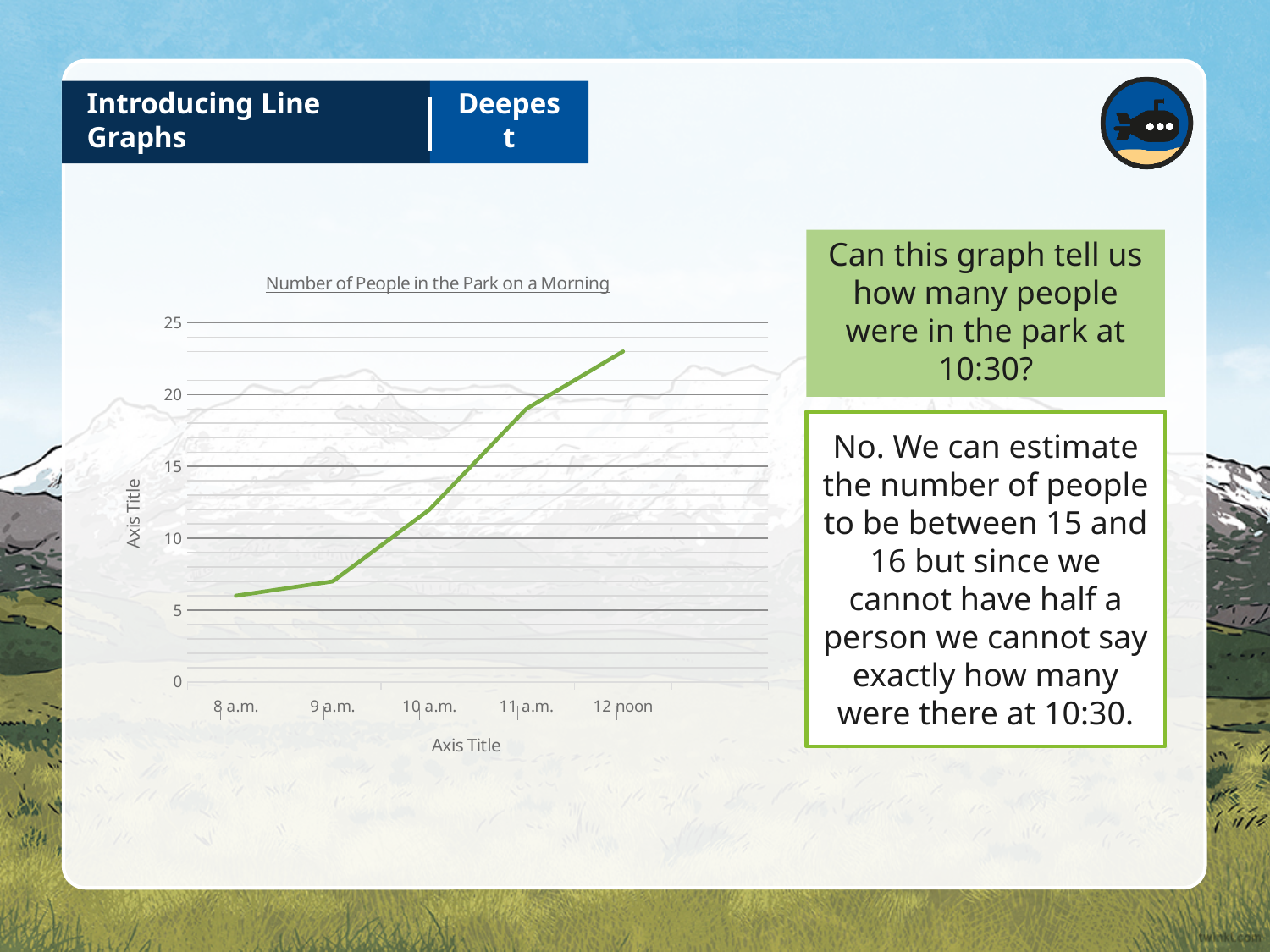
Which has a larger value, 9 a.m. or 11 a.m.? 11 a.m. At which time is the number of people in the park highest? 12 noon Is the value for 11 a.m. greater or less than 15? greater What is the title of the chart? Number of People in the Park on a Morning Is the value for 12 noon greater or less than 20? greater Do the values rise or fall from 8 a.m. to 12 noon? rise Is the value for 9 a.m. greater or less than 10? less How many time points are plotted on the x axis? 5 What colour is the plotted line? green What kind of chart is shown on the slide? line chart At which time is the number of people in the park lowest? 8 a.m.